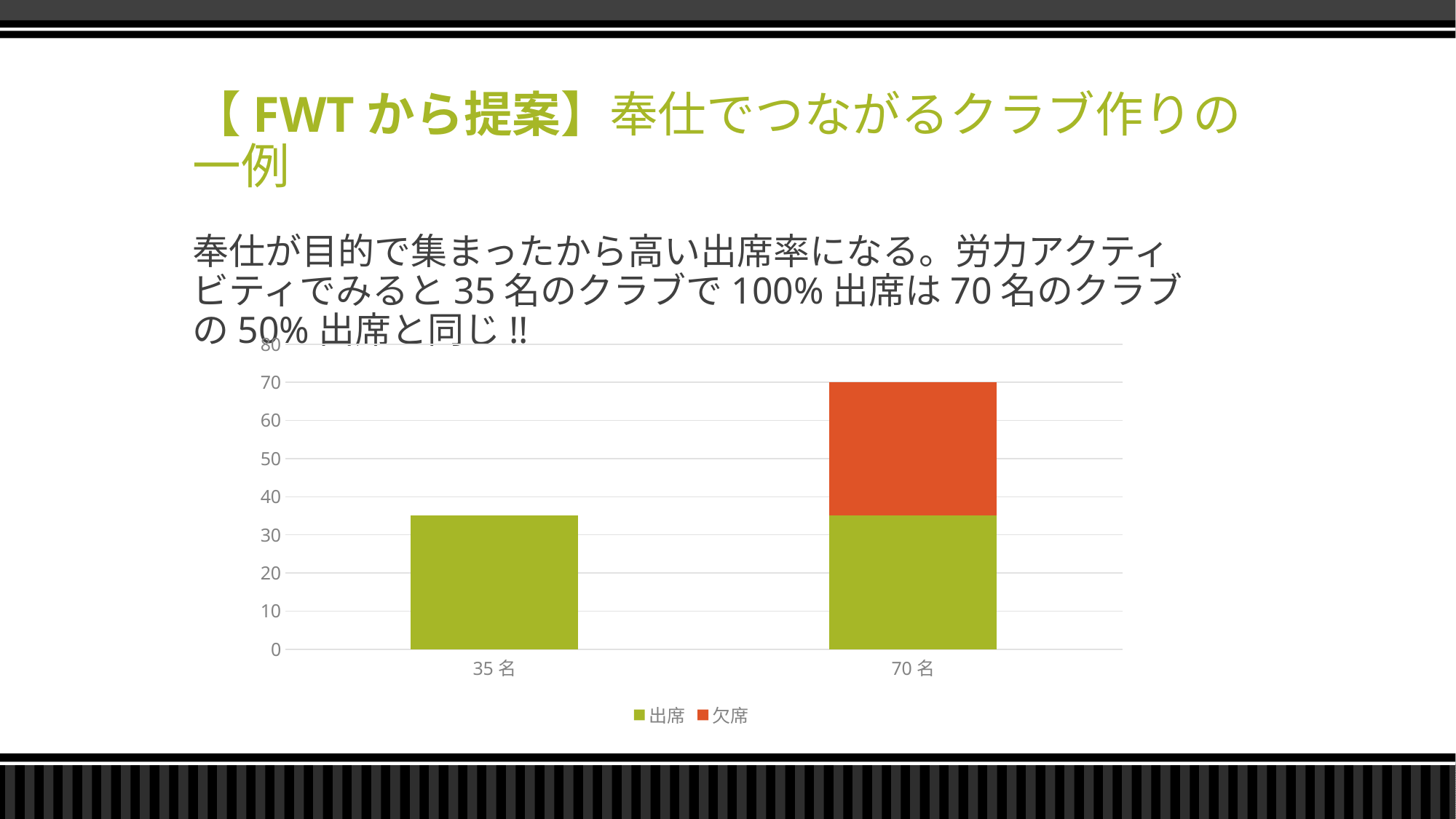
What kind of chart is shown on the slide? bar chart Is the total for 70名 greater or less than 60? greater Which category has the lowest total bar? 35名 How many categories are shown on the x axis of the chart? 2 Which colour represents 欠席 in the chart? orange What is the total height of the stacked bar for 70名? 70 Which category has the highest total bar? 70名 What are the two series listed in the chart legend? 出席, 欠席 How many series does the chart legend list? 2 Is the 出席 value for 35名 greater or less than 40? less Which category has the taller stacked bar, 35名 or 70名? 70名 Is the 出席 value for 35名 greater or less than 30? greater